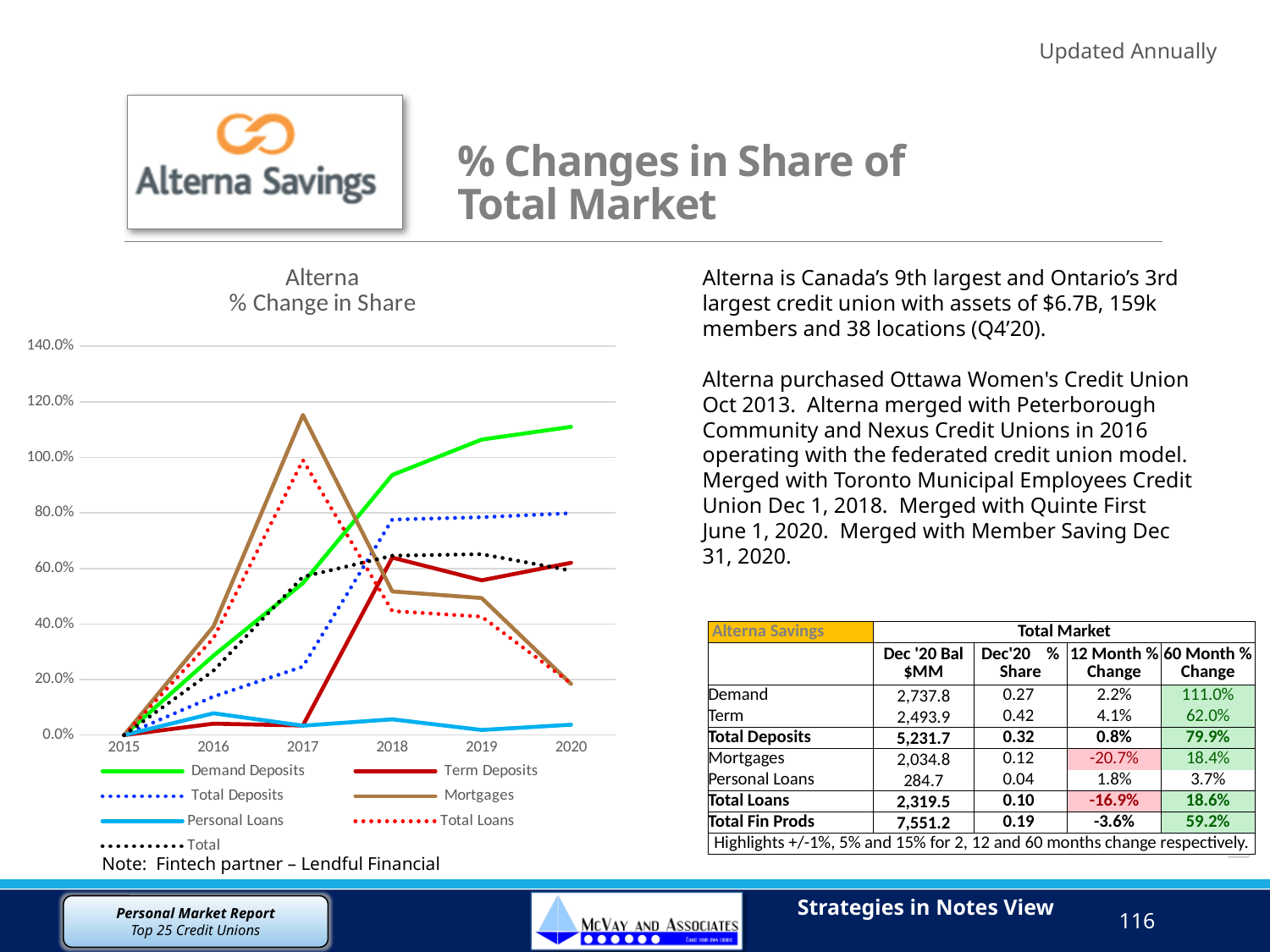
In 2017, which is larger: Mortgages or Demand Deposits? Mortgages Does the Demand Deposits line rise or fall from 2015 to 2020? rise In 2020, which is larger: Demand Deposits or Total Deposits? Demand Deposits Is the value for Demand Deposits in 2020 greater or less than 100.0%? greater What kind of chart is shown on the slide? line chart What is the title of the chart? Alterna % Change in Share Which series has the highest value in 2020? Demand Deposits Is the value for Personal Loans in 2018 greater or less than 20.0%? less Which series has the lowest value in 2020? Personal Loans How many series does the chart legend list? 7 Is the value for Mortgages in 2017 greater or less than 100.0%? greater How many years are shown along the x axis of the chart? 6